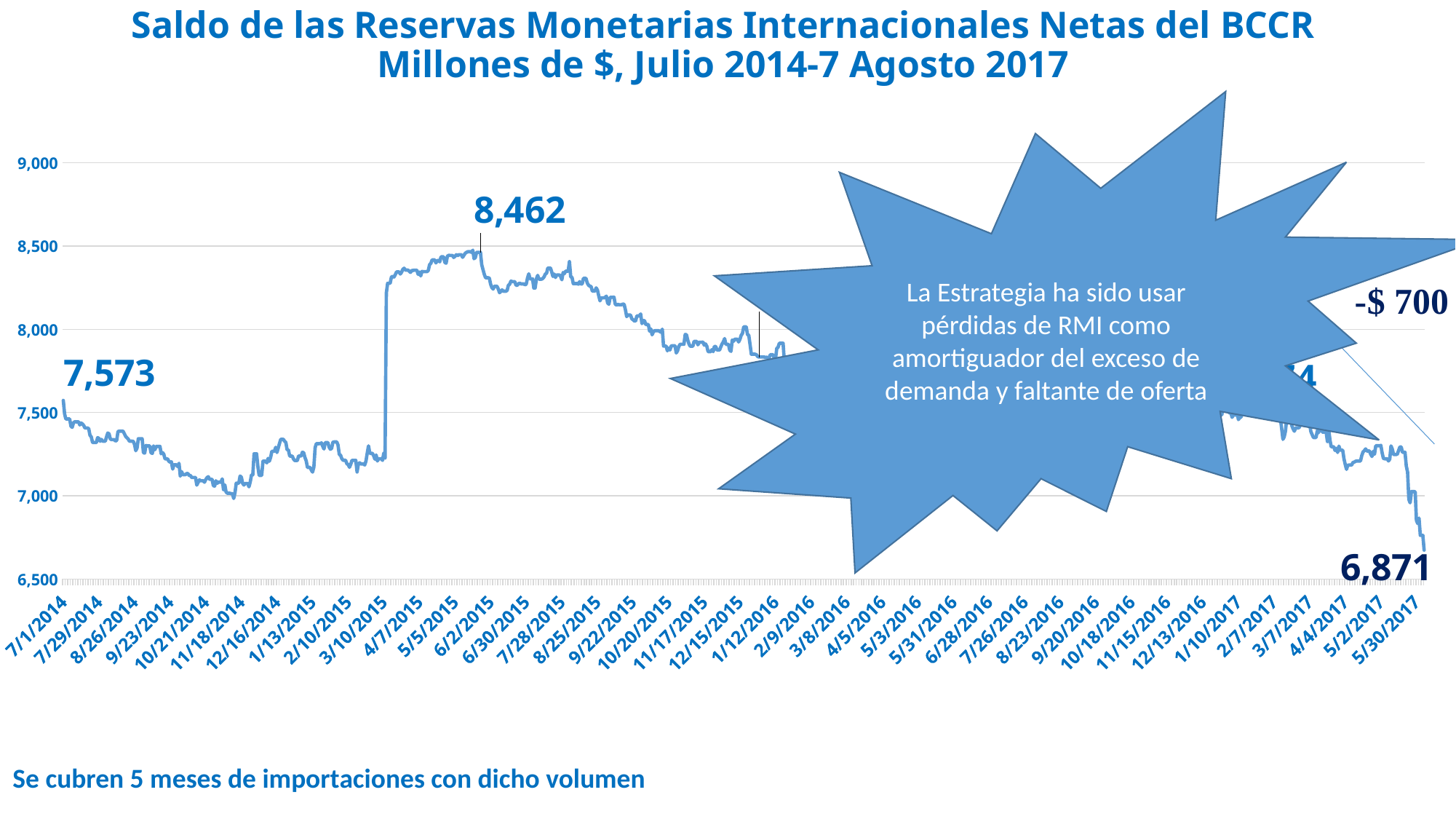
What is the difference between the peak value 8,462 and the starting value 7,573? 889 What is the lowest labelled value on the chart? 6,871 What is the value labelled at the start of the series in July 2014? 7,573 Is the value around 11/18/2014 greater or less than 7,500? less What is the title of the chart? Saldo de las Reservas Monetarias Internacionales Netas del BCCR Millones de $, Julio 2014-7 Agosto 2017 Does the series rise or fall between 6/2/2015 and 10/20/2015? fall What is the peak value labelled on the chart? 8,462 What is the difference between the starting value 7,573 and the final value 6,871? 702 Which is larger, the starting value in July 2014 or the final value labelled at the end of the series? the starting value (7,573) What type of chart is shown on the slide? line chart Is the value around 4/7/2015 greater or less than 8,000? greater What is the value labelled at the end of the series? 6,871